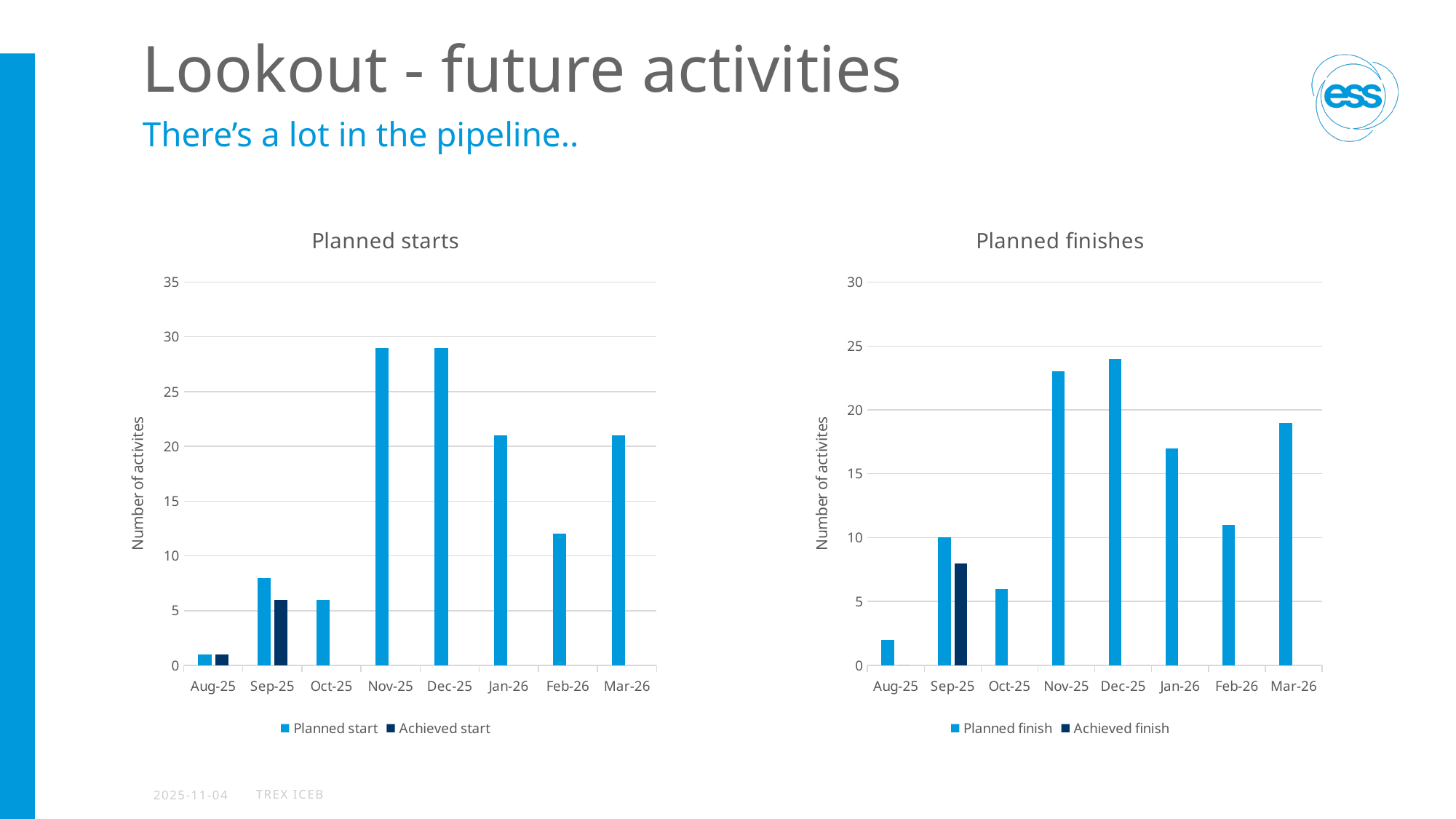
What are the two legend entries of the "Planned finishes" chart? Planned finish, Achieved finish In the "Planned starts" chart, which month has the lowest planned start value? Aug-25 In the "Planned starts" chart, is the planned start value for Nov-25 greater or less than 25? greater In the "Planned finishes" chart, which month has the lowest planned finish value? Aug-25 In the "Planned finishes" chart, is the planned finish value for Mar-26 greater or less than 20? less In the "Planned finishes" chart, what is the planned finish value for Sep-25? 10 How many series does the legend of the "Planned starts" chart list? 2 What kind of chart is the "Planned starts" chart? bar chart In the "Planned finishes" chart, is the planned finish value for Jan-26 greater or less than 15? greater In the "Planned starts" chart, which is larger, the planned start value for Jan-26 or for Feb-26? Jan-26 How many months are shown on the x axis of the "Planned finishes" chart? 8